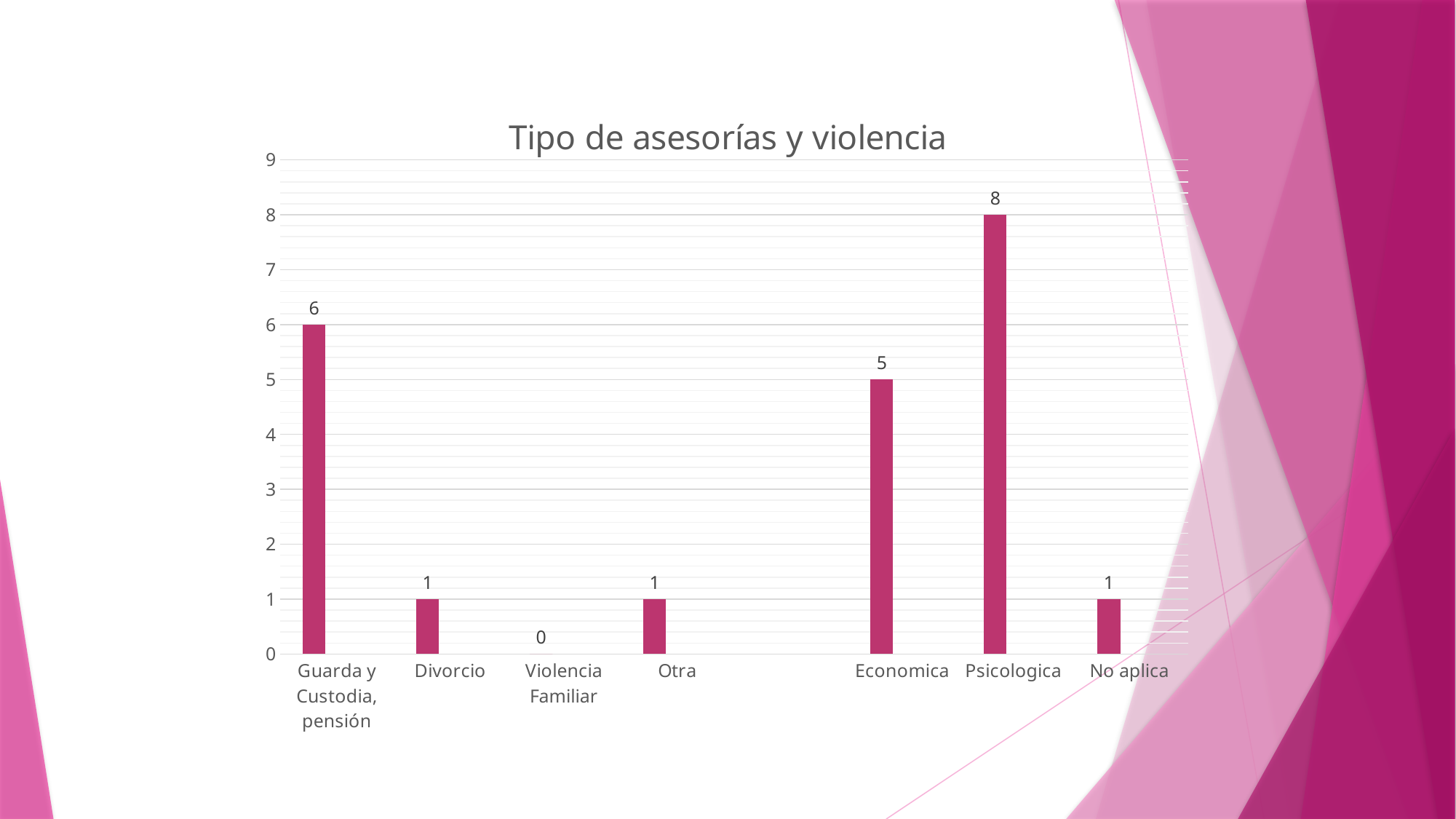
What is the value for Guarda y Custodia, pensión? 6 What is the value for Economica? 5 What kind of chart is shown on the slide? Bar chart What is the title of the chart? Tipo de asesorías y violencia What is the value for Psicologica? 8 Which category has the highest value? Psicologica What is the difference between the values for Psicologica and Economica? 3 What is the value for Divorcio? 1 What is the value for Violencia Familiar? 0 Which category has the lowest value? Violencia Familiar What is the difference between the values for Guarda y Custodia, pensión and No aplica? 5 Which is larger, the value for Guarda y Custodia, pensión or the value for Economica? Guarda y Custodia, pensión